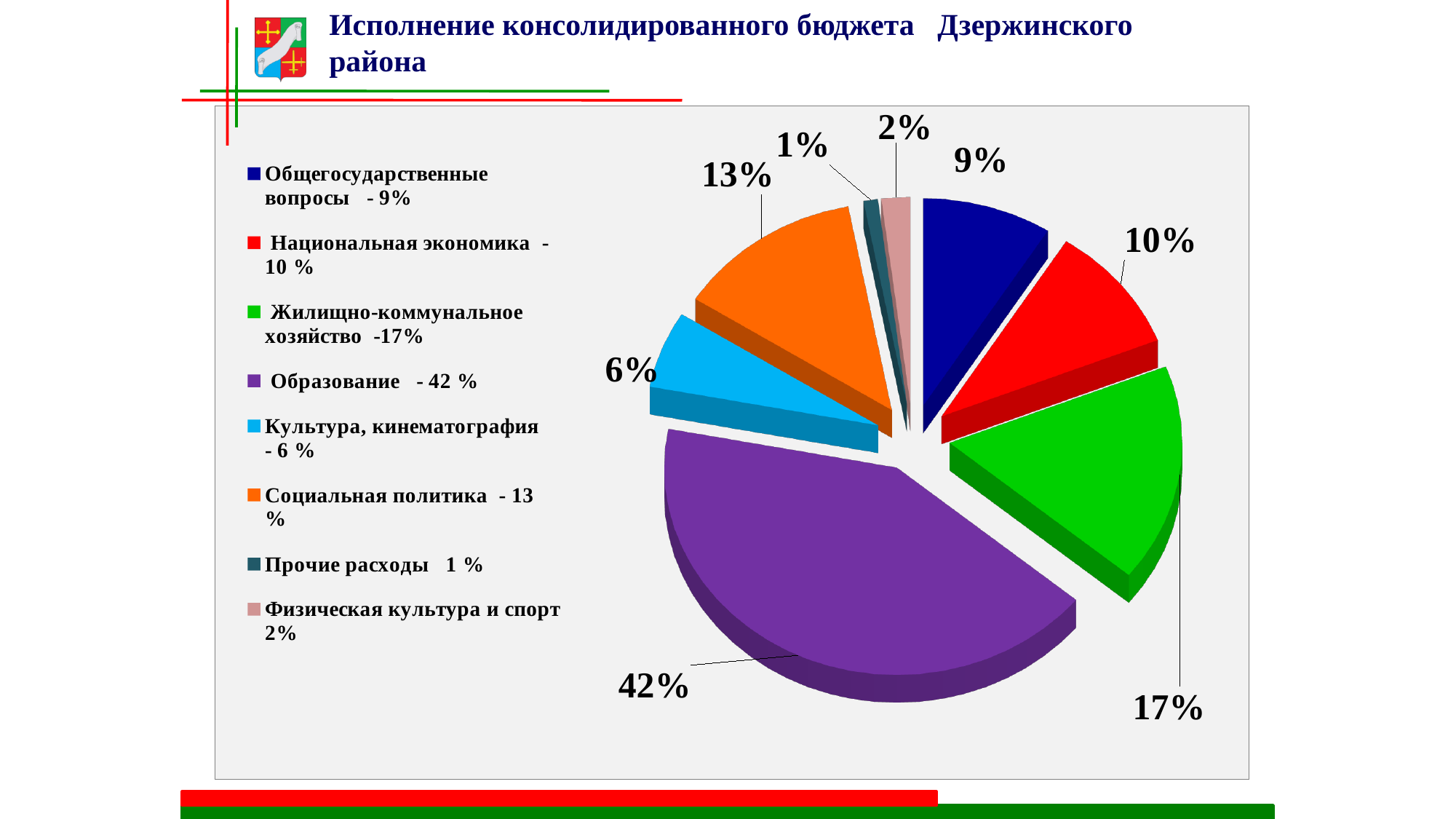
What is the difference between Образование and Жилищно-коммунальное хозяйство? 25% What is the value for Социальная политика? 13% What is the combined share of Прочие расходы and Физическая культура и спорт? 3% How many categories does the pie chart have? 8 Which category has the largest slice? Образование What share of the pie does Образование take? 42% What is the value for Культура, кинематография? 6% What is the value for Жилищно-коммунальное хозяйство? 17% What kind of chart is shown on the slide? pie chart Which category has the smallest slice? Прочие расходы Which is larger, Национальная экономика or Общегосударственные вопросы? Национальная экономика What colour is the slice for Социальная политика? orange